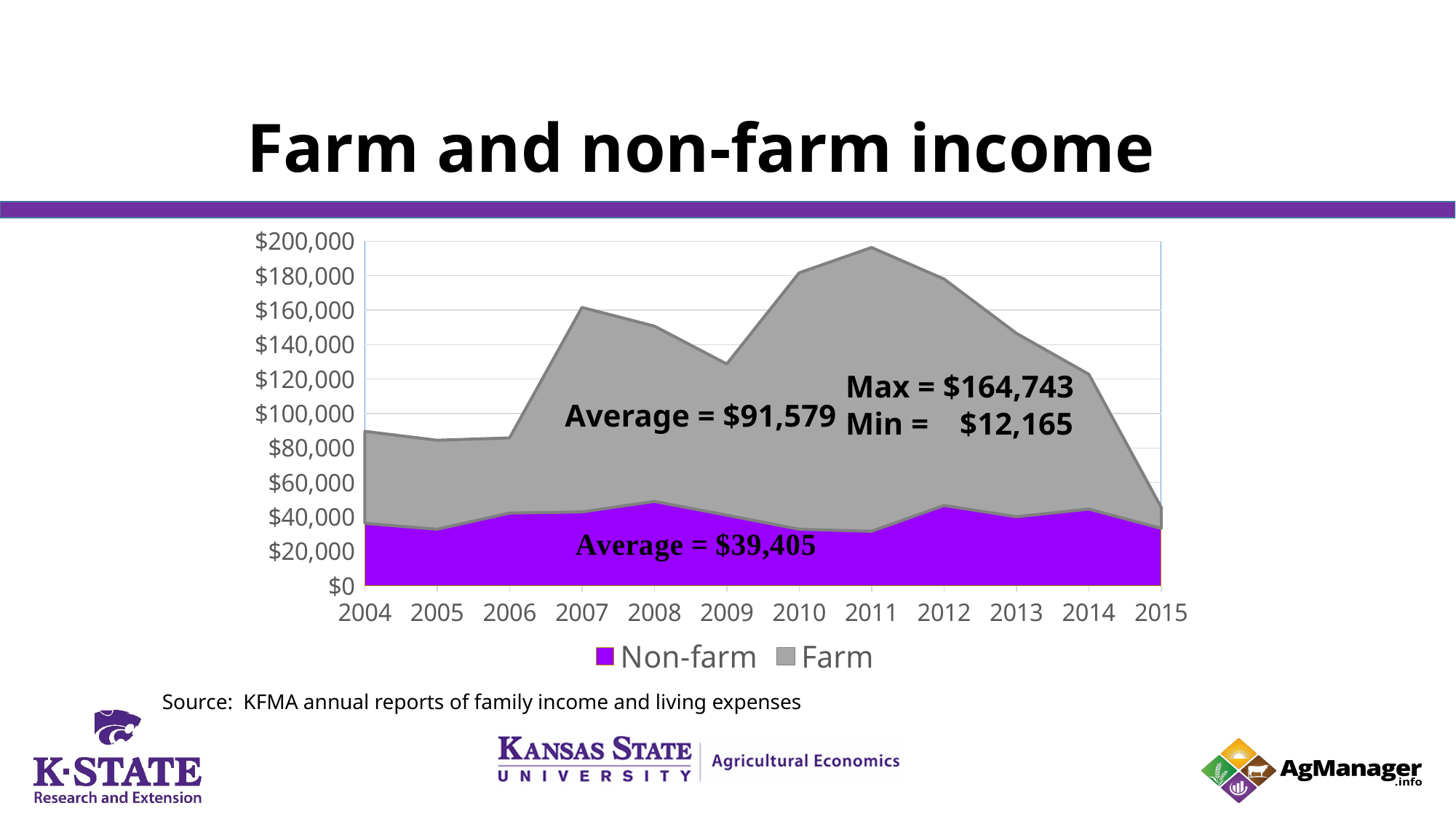
Is the total of farm and non-farm income in 2011 greater or less than $180,000? greater How many years are shown on the x axis? 12 What is the average farm income stated on the chart? $91,579 What is the minimum farm income stated on the chart? $12,165 Is the total of farm and non-farm income in 2015 greater or less than $60,000? less What is the maximum farm income stated on the chart? $164,743 How many series does the legend list? 2 In which year is the total of farm and non-farm income lowest? 2015 In which year is the total of farm and non-farm income highest? 2011 What type of chart is shown on the slide? Stacked area chart Which series is shown in purple? Non-farm What is the average non-farm income stated on the chart? $39,405